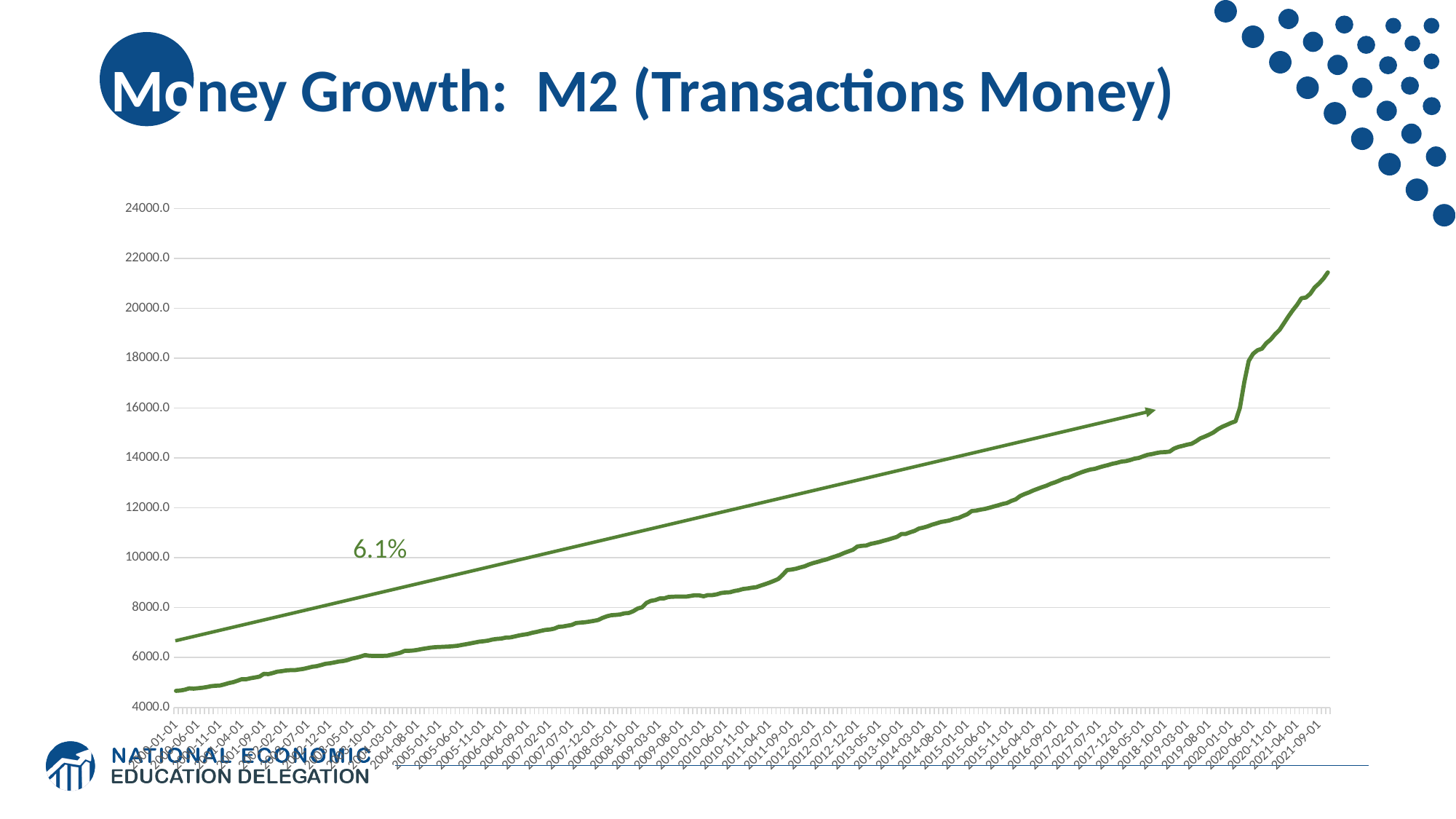
Is the value for 2005-01-01 greater or less than 8000? less Is the value for 2020-01-01 greater or less than 14000? greater What growth rate is annotated next to the straight arrow on the chart? 6.1% What kind of chart is shown on the slide? line chart What is the title of the slide's chart? Money Growth: M2 (Transactions Money) Do the M2 values generally rise or fall from left to right along the x axis? rise Is the value for 2010-01-01 greater or less than 10000? less What is the highest tick value shown on the y axis? 24000.0 Which is larger, the value for 2021-04-01 or the value for 2019-03-01? 2021-04-01